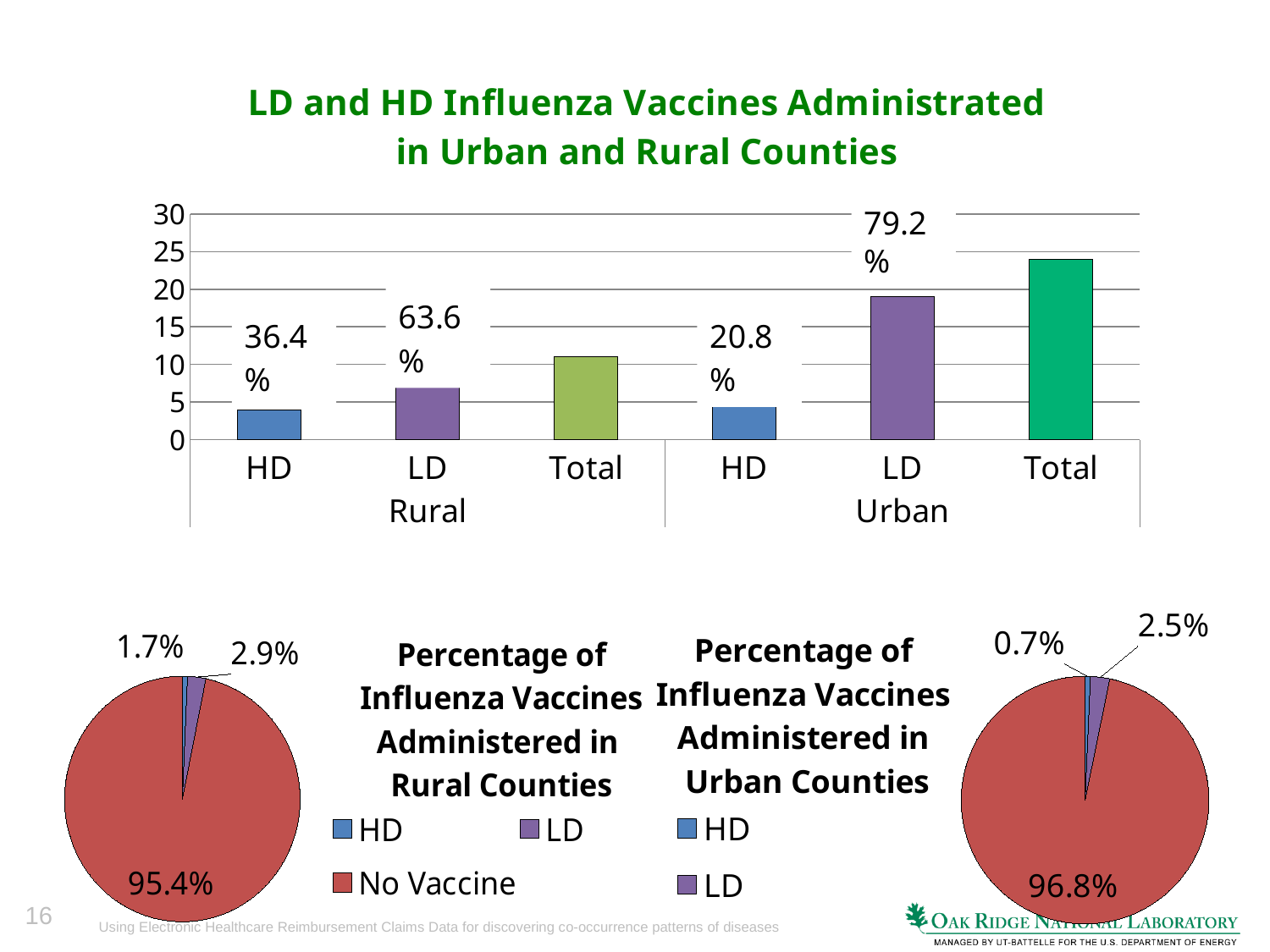
In the pie chart 'Percentage of Influenza Vaccines Administered in Rural Counties', what is the difference between the LD share and the HD share? 1.2% In the top bar chart, is the value for the Rural HD bar greater or less than 5? less How many bars are plotted in the top bar chart? 6 In the top bar chart, is the value for the Urban Total bar greater or less than 20? greater In the top bar chart, is the LD bar taller in the Rural group or the Urban group? Urban Is the HD share larger in the Rural Counties pie chart or the Urban Counties pie chart? Rural Counties In the top bar chart, what percentage label is printed above the HD bar in the Rural group? 36.4% In the pie chart 'Percentage of Influenza Vaccines Administered in Rural Counties', what share is No Vaccine? 95.4% In the top bar chart, what percentage label is printed above the LD bar in the Urban group? 79.2% What type of chart is the top chart titled 'LD and HD Influenza Vaccines Administrated in Urban and Rural Counties'? bar chart In the pie chart 'Percentage of Influenza Vaccines Administered in Urban Counties', what share is LD? 2.5% In the top bar chart, which bar is the tallest? Urban Total